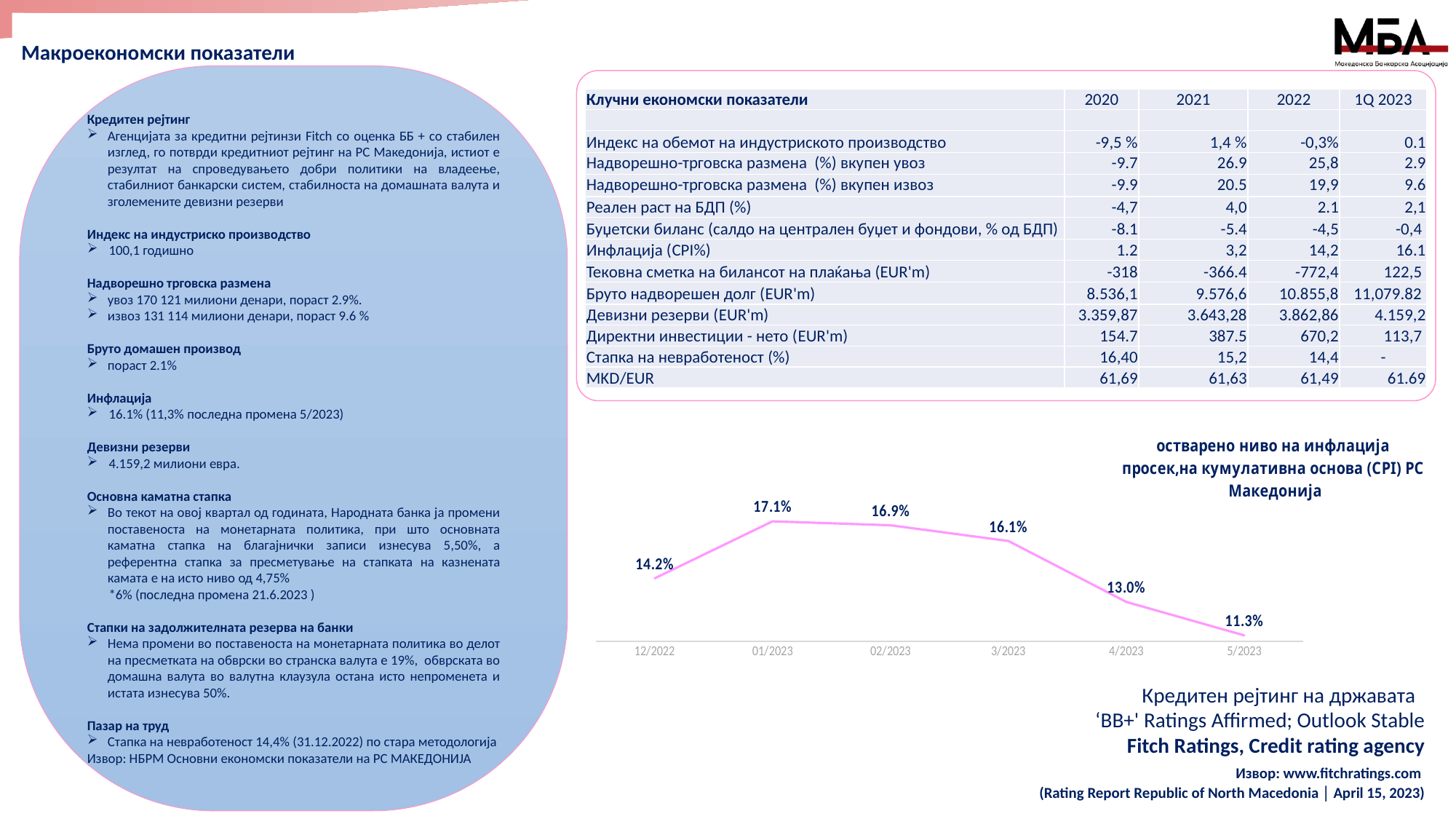
What colour is the line in the inflation chart? pink What is the inflation value for 5/2023 in the line chart? 11.3% Which is larger, the inflation value for 02/2023 or for 3/2023? 02/2023 What type of chart is shown on the slide? line chart Which month has the highest inflation value in the line chart? 01/2023 What is the difference between the inflation values for 01/2023 and 5/2023? 5.8% What is the inflation value for 4/2023 in the line chart? 13.0% Which month has the lowest inflation value in the line chart? 5/2023 Does the inflation line rise or fall from 02/2023 to 5/2023? fall What is the inflation value for 01/2023 in the line chart? 17.1% How many data points are plotted in the line chart? 6 What is the inflation value for 12/2022 in the line chart? 14.2%